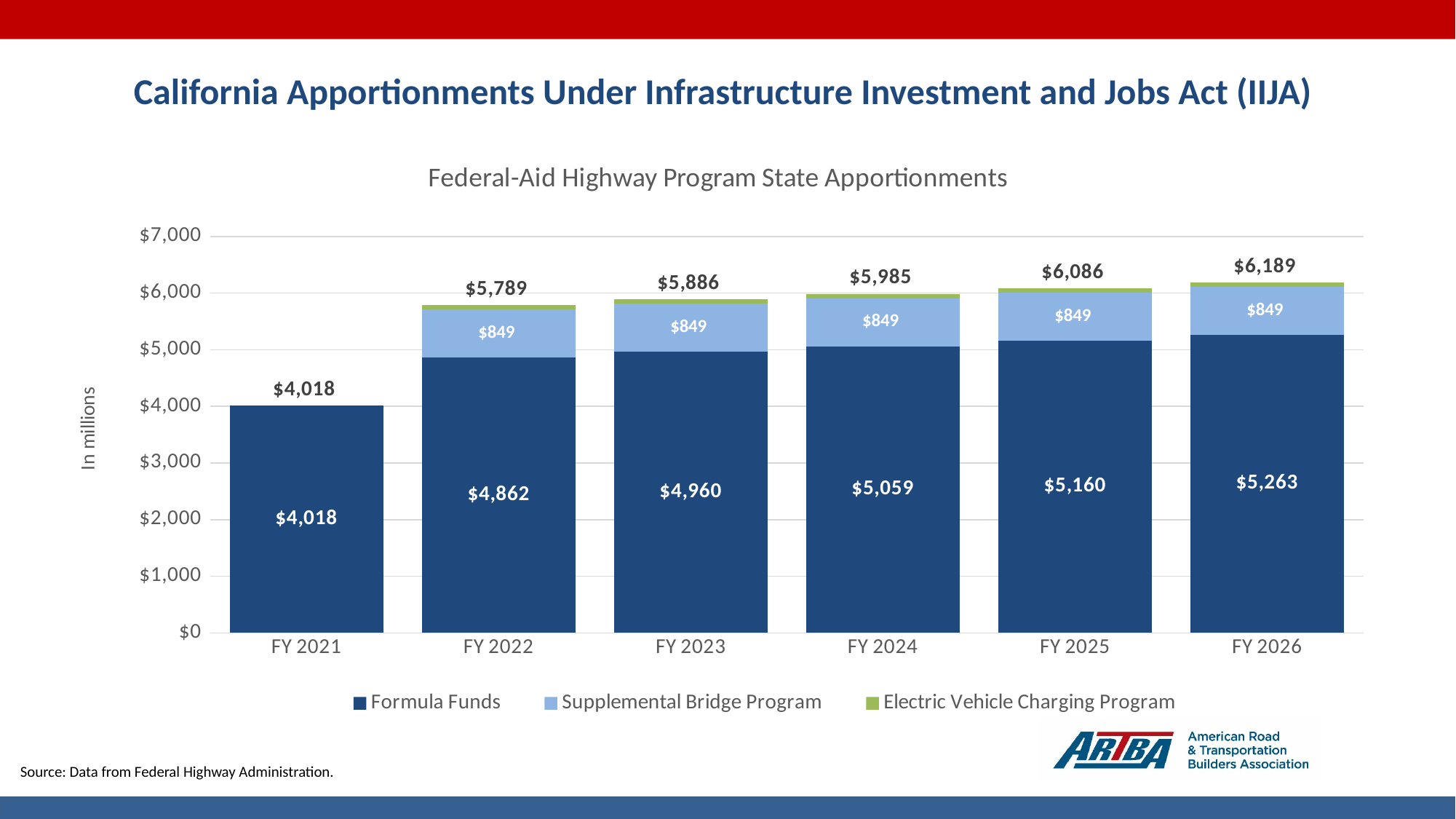
Do the total apportionments rise or fall from FY 2021 to FY 2026? rise Which fiscal year has the highest total apportionment? FY 2026 What is the Supplemental Bridge Program value for FY 2025? $849 Which fiscal year has the lowest total apportionment? FY 2021 Is the total apportionment for FY 2021 greater or less than $5,000? less What kind of chart is shown on the slide? stacked bar chart Which is larger, the Formula Funds value for FY 2023 or for FY 2022? FY 2023 How many series does the legend list? 3 What is the total apportionment shown for FY 2022? $5,789 What is the difference between the Formula Funds values for FY 2026 and FY 2021? $1,245 What is the Formula Funds value for FY 2024? $5,059 How many fiscal years are shown on the x axis? 6